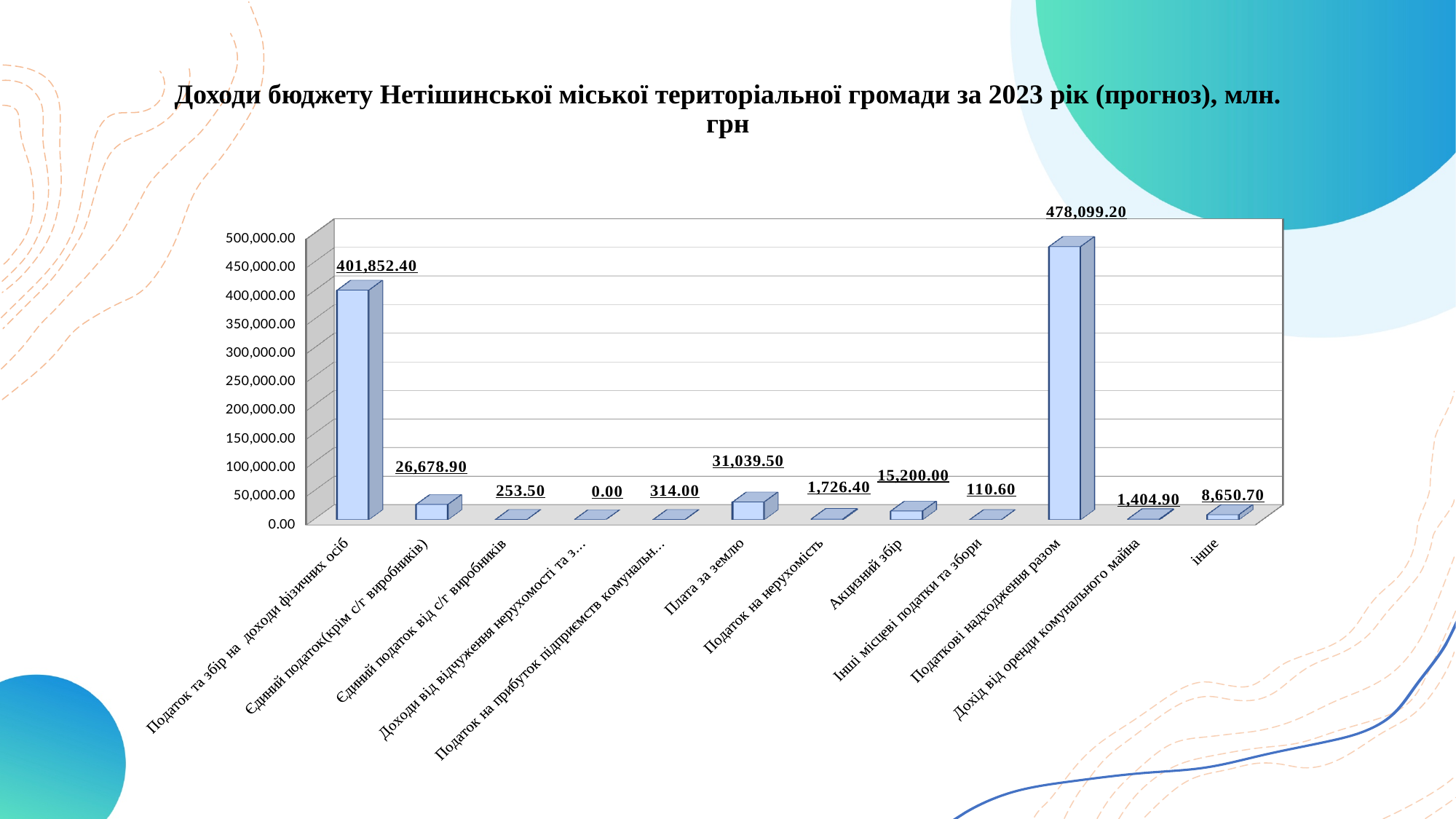
What kind of chart is shown on the slide? bar chart What is the value for Податкові надходження разом? 478,099.20 Which category has the lowest value? Доходи від відчуження нерухомості та з... What is the difference between the values for Податкові надходження разом and Податок та збір на доходи фізичних осіб? 76,246.80 What is the difference between the values for Плата за землю and Єдиний податок(крім с/г виробників)? 4,360.60 Which category has the highest value? Податкові надходження разом Is the value for Податок та збір на доходи фізичних осіб greater or less than 350,000.00? greater What is the value for Дохід від оренди комунального майна? 1,404.90 What is the value for Плата за землю? 31,039.50 Which is larger, the value for Акцизний збір or the value for Плата за землю? Плата за землю How many categories are shown on the chart? 12 What is the value for Акцизний збір? 15,200.00